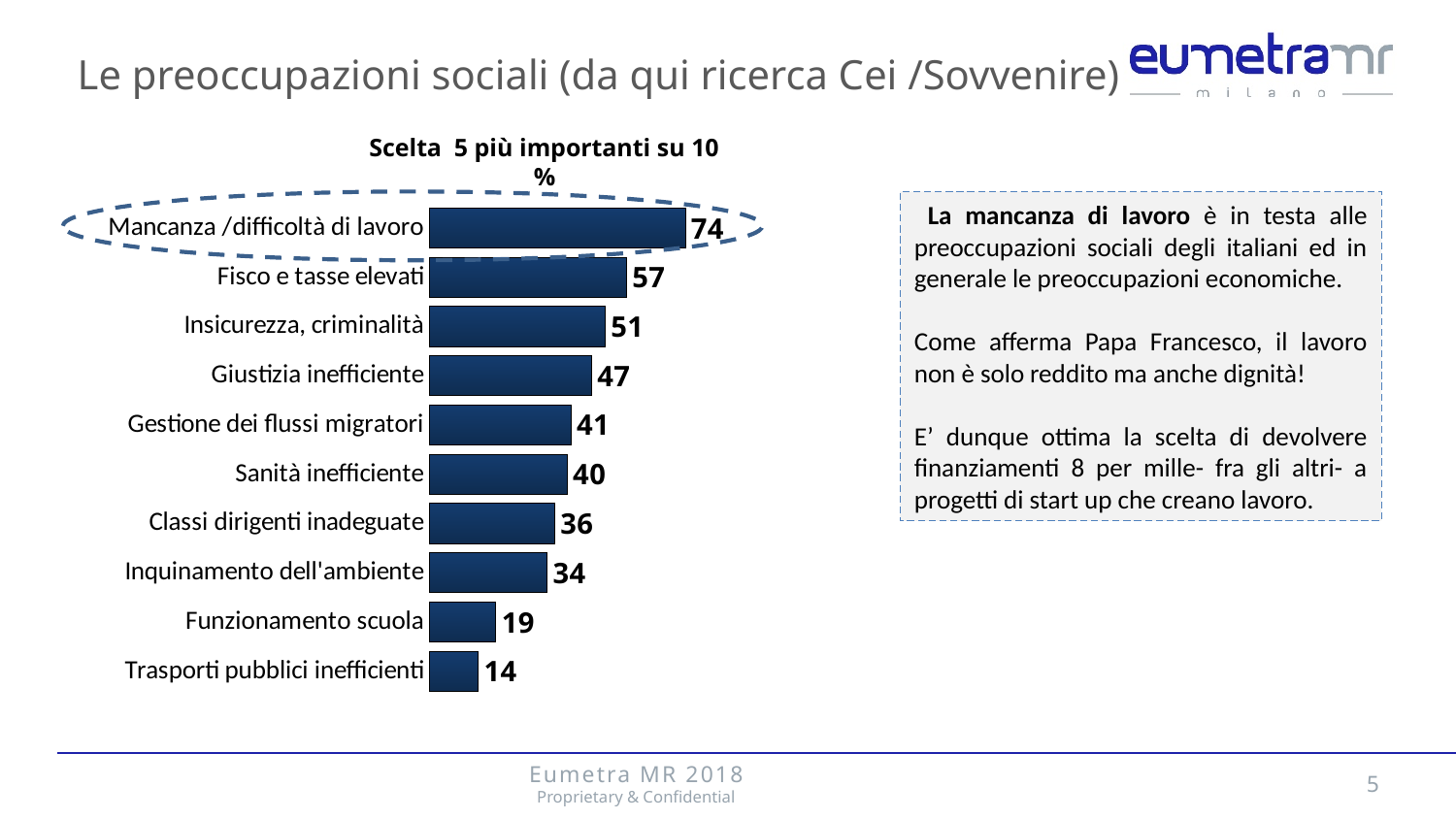
Which category has the highest value? Mancanza /difficoltà di lavoro Which category is circled with a dashed outline on the chart? Mancanza /difficoltà di lavoro What is the value for Fisco e tasse elevati? 57 What is the difference between the values for Sanità inefficiente and Inquinamento dell'ambiente? 6 What is the title of the chart? Scelta 5 più importanti su 10 What is the value for Gestione dei flussi migratori? 41 What is the difference between the values for Mancanza /difficoltà di lavoro and Fisco e tasse elevati? 17 What is the value for Funzionamento scuola? 19 Which is larger, the value for Insicurezza, criminalità or the value for Giustizia inefficiente? Insicurezza, criminalità How many categories are shown in the chart? 10 What kind of chart is shown on the slide? bar chart Which category has the lowest value? Trasporti pubblici inefficienti